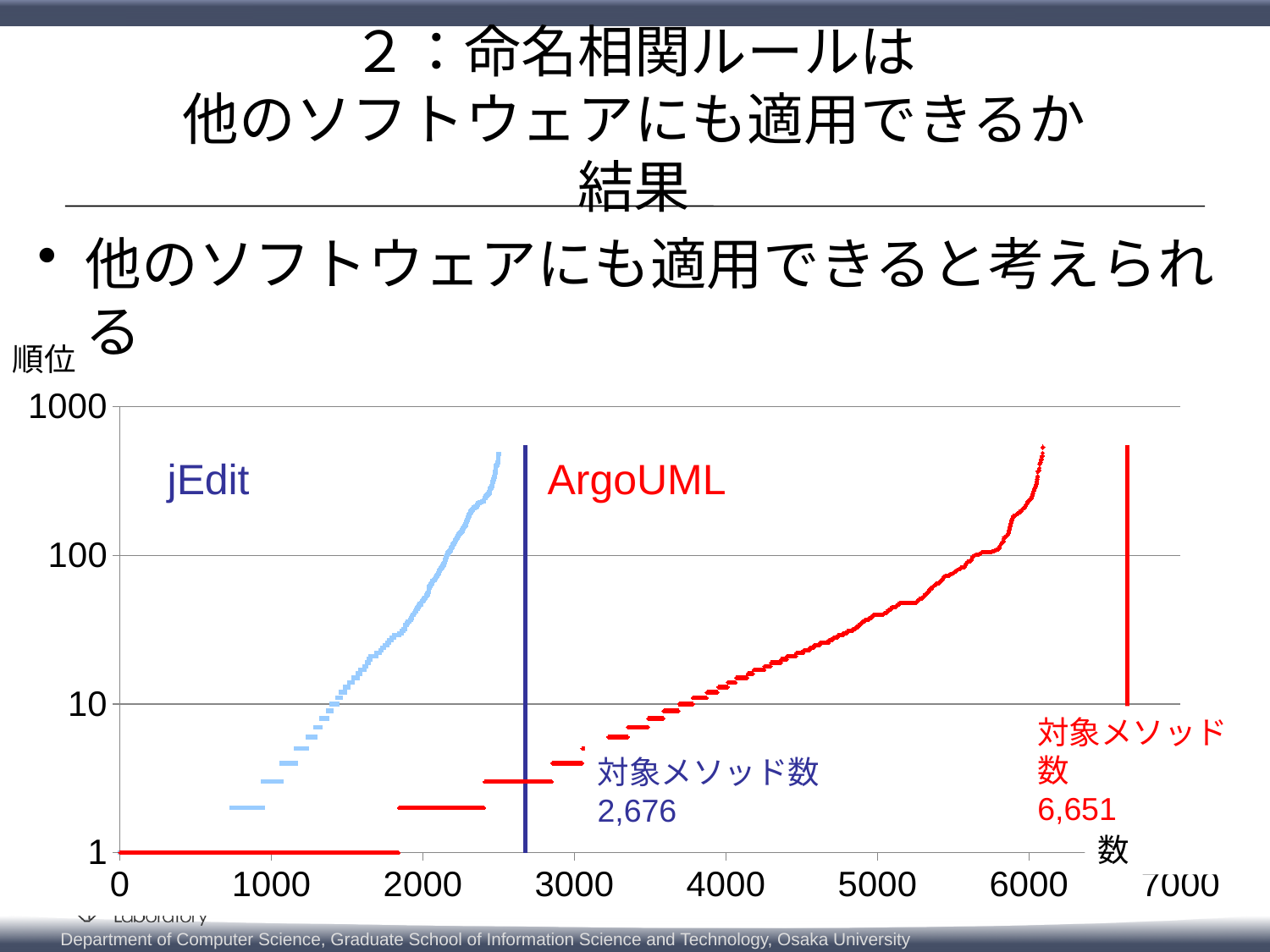
Which colour is used for the ArgoUML series? red How many software projects (series) are plotted on the chart? 2 What is the label of the vertical axis? 順位 What is the difference between the number of target methods for ArgoUML and for jEdit? 3,975 Is the number of target methods for jEdit greater or less than 3000? less Is the number of target methods for ArgoUML greater or less than 6000? greater What is the 対象メソッド数 (number of target methods) for ArgoUML? 6,651 What kind of chart is shown on the slide? scatter chart Do the plotted ranks (順位) rise or fall as the count on the x axis increases? rise Which software has the larger number of target methods, jEdit or ArgoUML? ArgoUML What is the 対象メソッド数 (number of target methods) for jEdit? 2,676 What is the highest tick value shown on the vertical axis? 1000